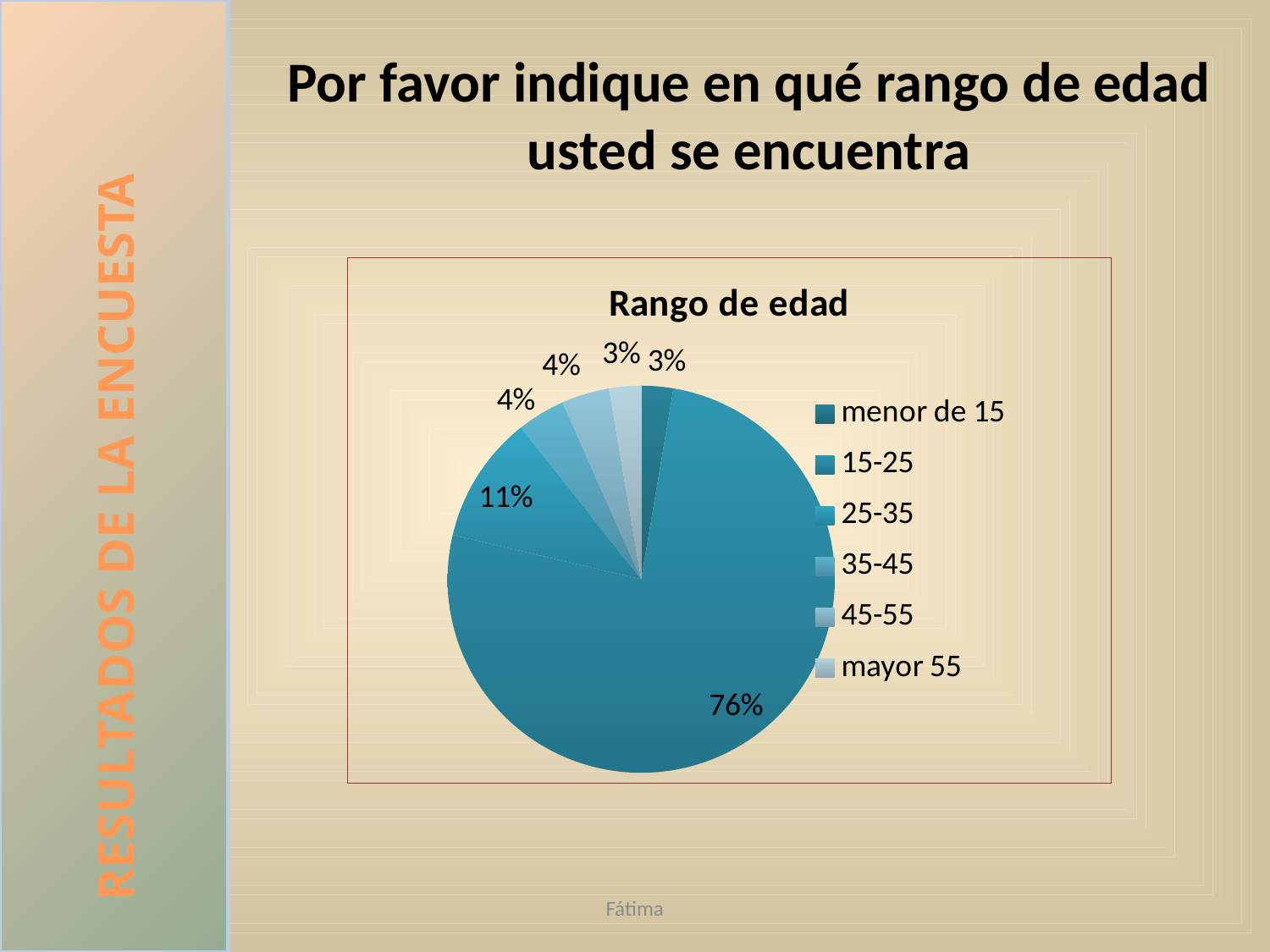
What percentage of respondents are in the 25-35 age range? 11% What kind of chart is shown on the slide? Pie chart What is the difference in percentage points between the 15-25 slice and the 25-35 slice? 65 percentage points What percentage of respondents are in the 15-25 age range? 76% What percentage of respondents are 'menor de 15'? 3% What percentage of respondents are in the 35-45 age range? 4% What share of the pie does the 'mayor 55' slice represent? 3% What is the last entry listed in the chart legend? mayor 55 What is the title of the chart? Rango de edad How many age ranges are shown in the pie chart? 6 Which slice is larger, 25-35 or 45-55? 25-35 Which age range has the largest share of the pie? 15-25